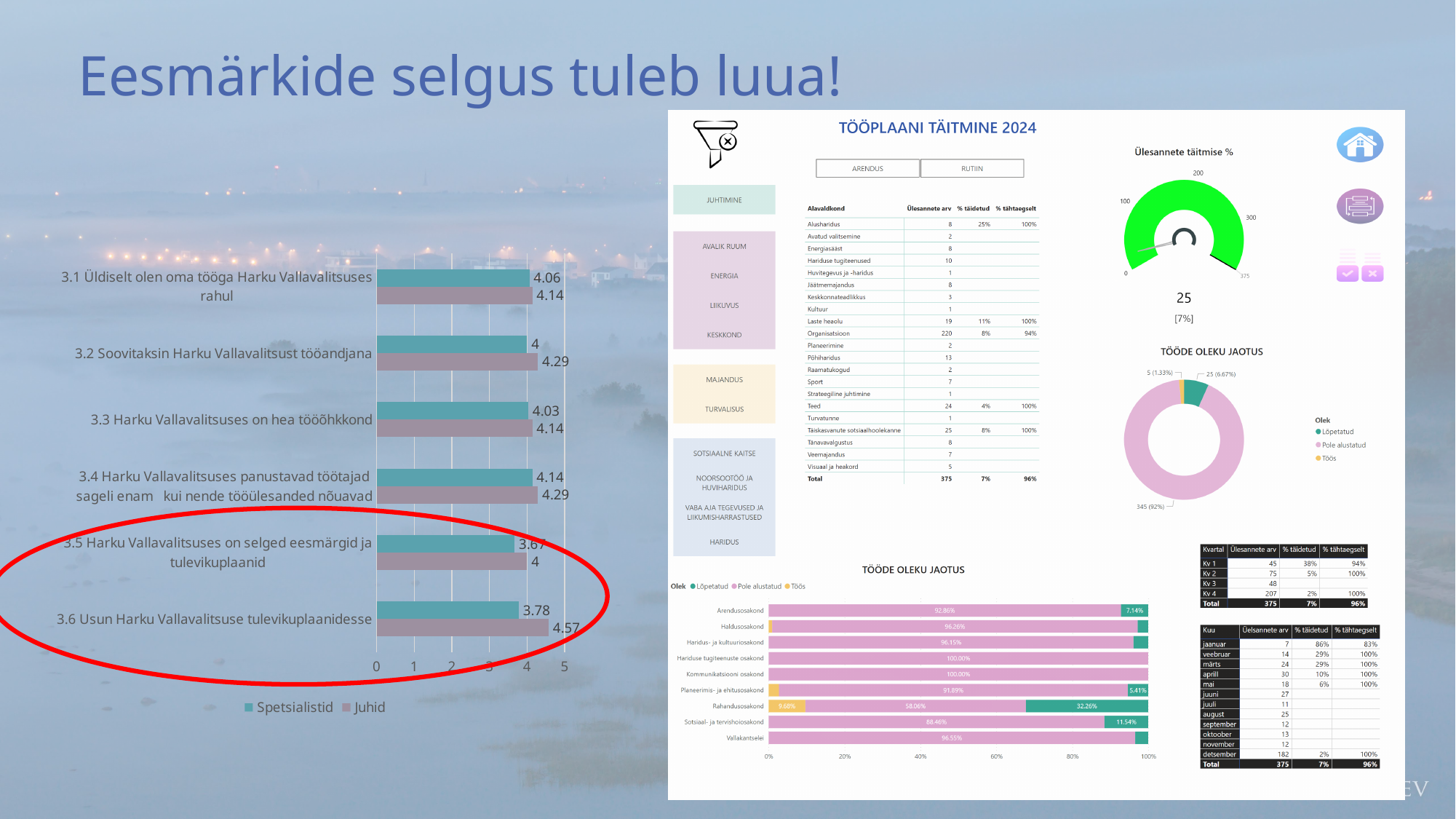
On the left bar chart, which statement has the highest Juhid value? 3.6 Usun Harku Vallavalitsuse tulevikuplaanidesse How many statements (categories) are shown on the left bar chart? 6 On the left bar chart, which statement has the lowest Spetsialistid value? 3.5 Harku Vallavalitsuses on selged eesmärgid ja tulevikuplaanid On the donut chart titled TÖÖDE OLEKU JAOTUS on the right, what is the value shown for Pole alustatud? 345 (92%) On the left bar chart, what is the difference between the Juhid and Spetsialistid values for statement 3.6? 0.79 What type of chart is the chart on the left of the slide? bar chart On the left bar chart, for statement 3.2 Soovitaksin Harku Vallavalitsust tööandjana, which is larger: the Spetsialistid value or the Juhid value? Juhid On the left bar chart, which series is shown in teal? Spetsialistid How many series does the legend of the left bar chart list? 2 On the stacked bar chart titled TÖÖDE OLEKU JAOTUS at the bottom right, what is the Lõpetatud share for Rahandusosakond? 32.26% On the left bar chart, what is the value for Juhid for statement 3.6 Usun Harku Vallavalitsuse tulevikuplaanidesse? 4.57 On the left bar chart, what is the value for Spetsialistid for statement 3.5 Harku Vallavalitsuses on selged eesmärgid ja tulevikuplaanid? 3.67